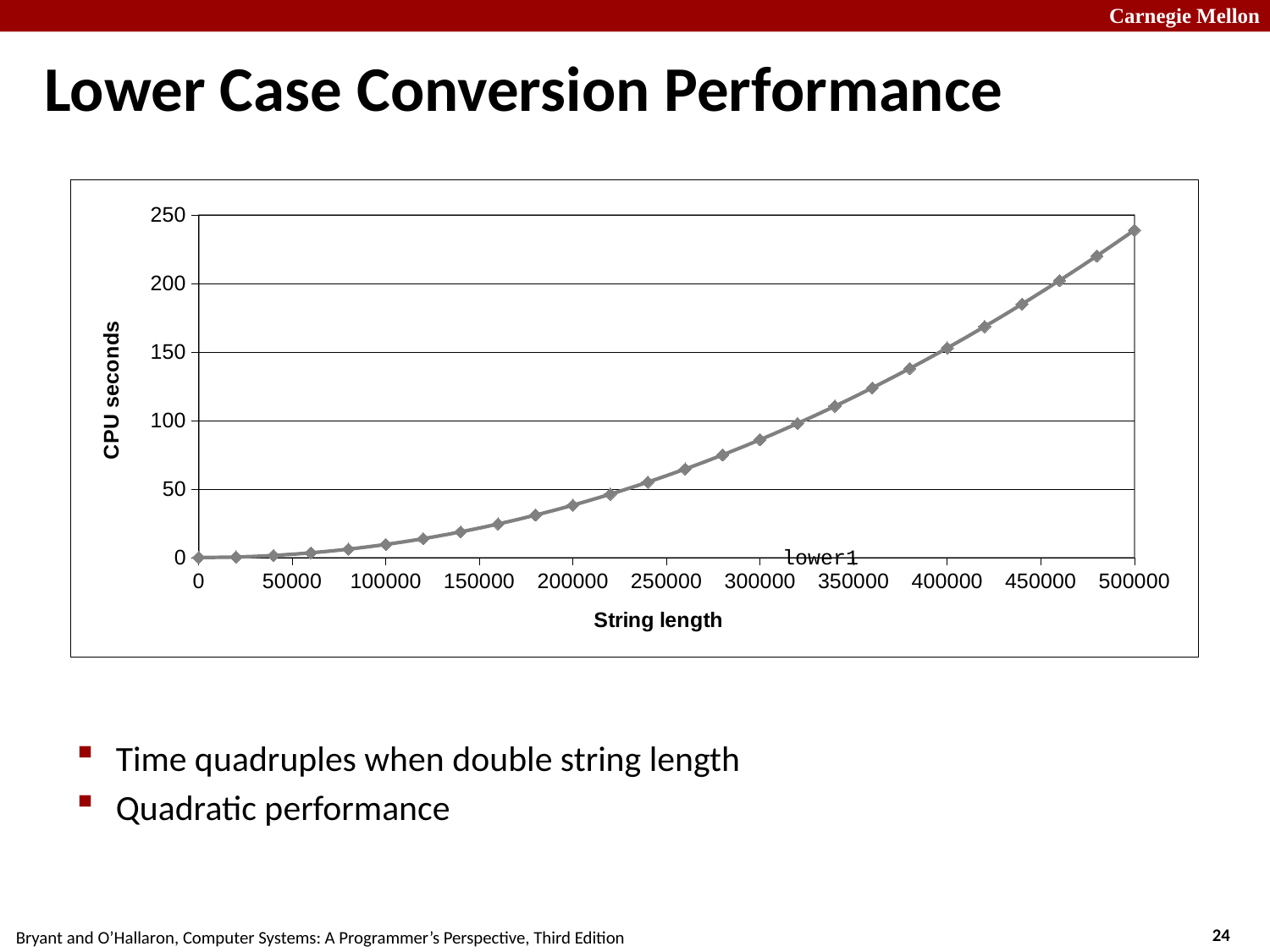
What is the title of the y axis of the chart? CPU seconds At which string length is the CPU time lowest? 0 Is the CPU time at a string length of 300000 greater or less than 100? less Is the CPU time at a string length of 500000 greater or less than 200? greater Is the CPU time at a string length of 200000 greater or less than 50? less What kind of chart is shown on the slide? line chart Do the CPU seconds rise or fall as string length increases? rise At which string length is the CPU time highest? 500000 Which has the larger CPU time: a string length of 100000 or a string length of 400000? 400000 What is the title of the x axis of the chart? String length